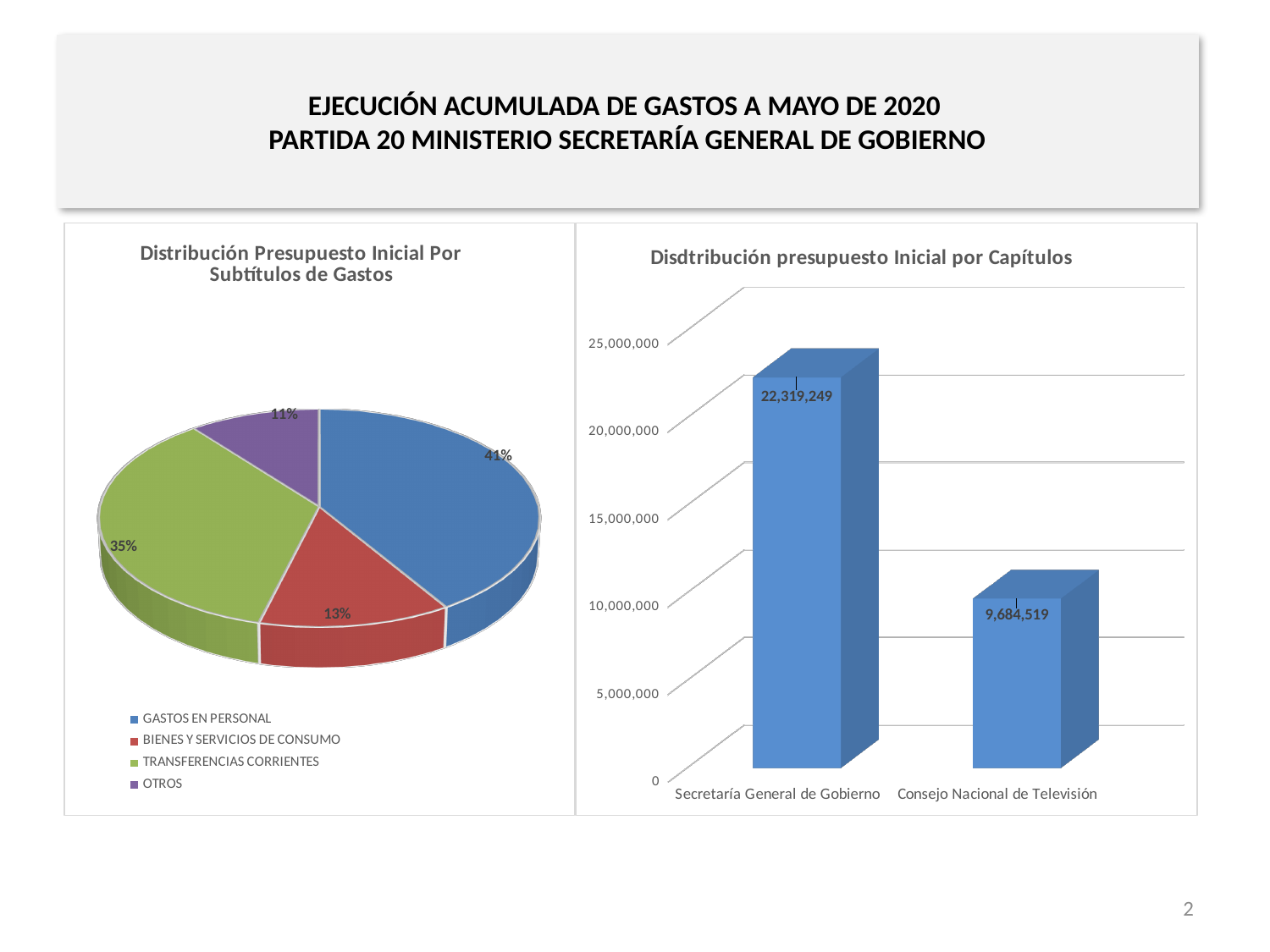
What kind of chart is the one on the right of the slide? Bar chart In the pie chart on the left, what colour is the OTROS slice? Purple In the chart titled 'Disdtribución presupuesto Inicial por Capítulos', what is the value for Consejo Nacional de Televisión? 9,684,519 In the chart titled 'Disdtribución presupuesto Inicial por Capítulos', is the value for Consejo Nacional de Televisión greater or less than 10,000,000? less In the pie chart on the left, how many categories does the legend list? 4 In the pie chart on the left, which category has the largest share? GASTOS EN PERSONAL In the pie chart on the left, what share does TRANSFERENCIAS CORRIENTES have? 35% In the pie chart on the left, what share does BIENES Y SERVICIOS DE CONSUMO have? 13% In the pie chart on the left, what share does GASTOS EN PERSONAL have? 41% In the chart titled 'Disdtribución presupuesto Inicial por Capítulos', what is the difference between Secretaría General de Gobierno and Consejo Nacional de Televisión? 12,634,730 In the pie chart on the left, which category has the smallest share? OTROS In the chart titled 'Disdtribución presupuesto Inicial por Capítulos', what is the value for Secretaría General de Gobierno? 22,319,249